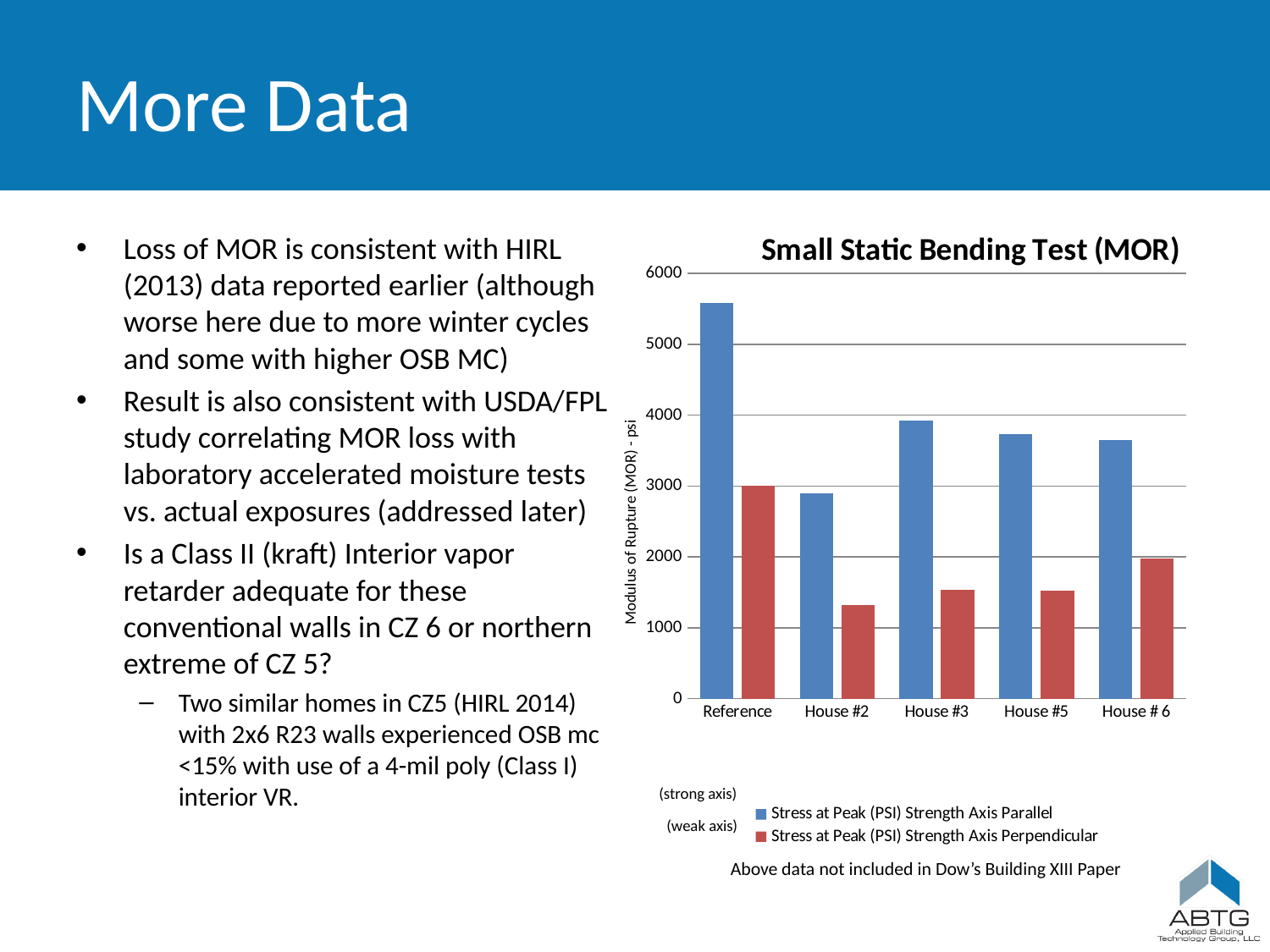
Which category has the lowest Stress at Peak (PSI) Strength Axis Perpendicular value? House #2 Is the Strength Axis Parallel value for House #5 greater or less than 3000? greater How many categories are shown on the x axis of the Small Static Bending Test (MOR) chart? 5 Which is larger, the Strength Axis Perpendicular value for House # 6 or for House #2? House # 6 How many series does the legend of the Small Static Bending Test (MOR) chart list? 2 Is the Strength Axis Parallel value for Reference greater or less than 5000? greater Is the Strength Axis Parallel value for House #2 greater or less than 3000? less What is the label on the y axis of the Small Static Bending Test (MOR) chart? Modulus of Rupture (MOR) - psi What kind of chart is the Small Static Bending Test (MOR) chart? bar chart Which category has the highest Stress at Peak (PSI) Strength Axis Parallel value? Reference Which is larger, the Strength Axis Parallel value for Reference or for House #2? Reference